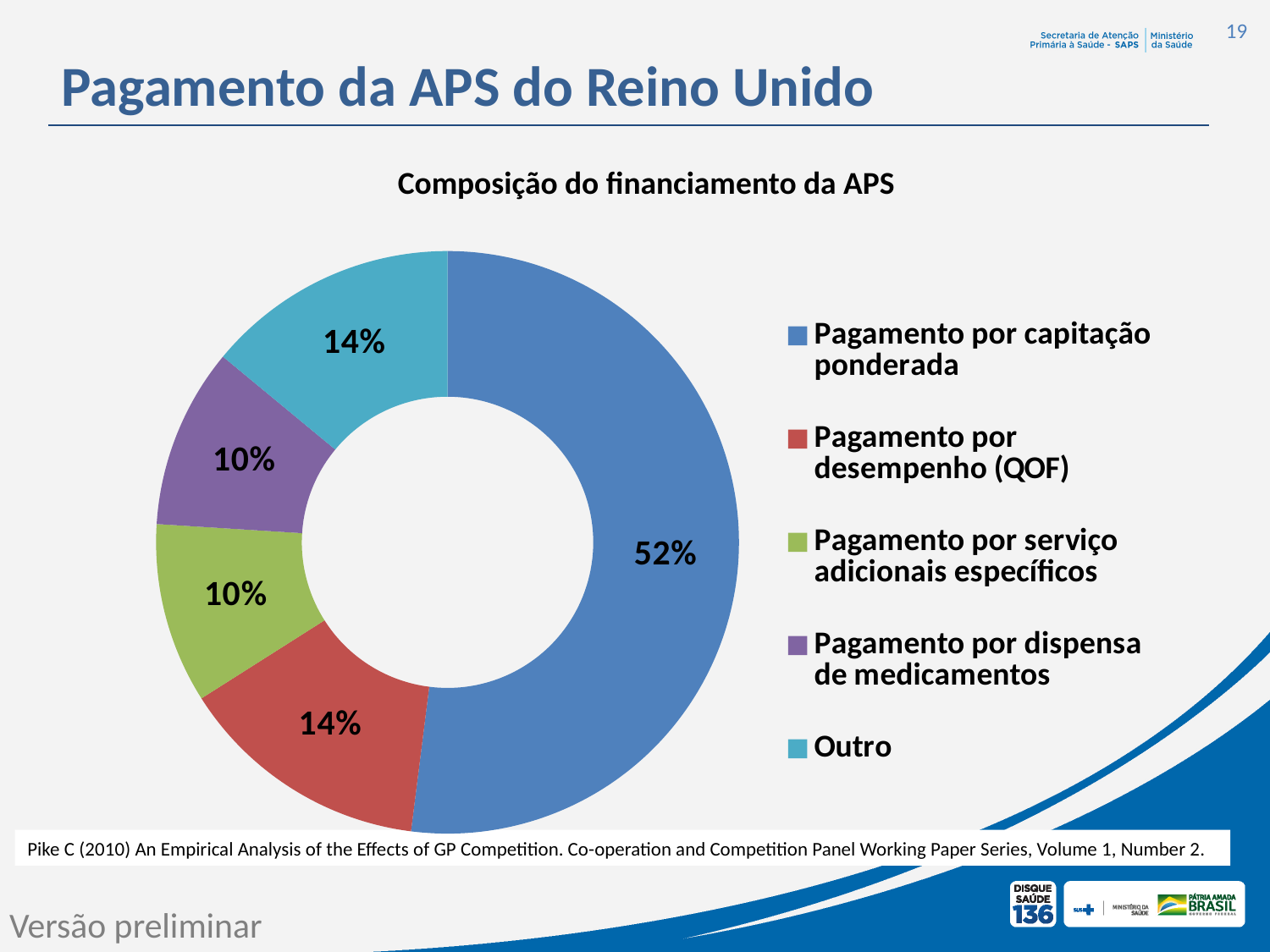
What kind of chart is shown on the slide? Pie chart (donut) What is the difference between the share for Pagamento por desempenho (QOF) and the share for Pagamento por dispensa de medicamentos? 4% What share of the chart does Pagamento por capitação ponderada represent? 52% How many categories are shown in the chart? 5 What is the value shown for Pagamento por dispensa de medicamentos? 10% What is the value shown for Outro? 14% What is the value shown for Pagamento por serviço adicionais específicos? 10% Which category has the largest share of the chart? Pagamento por capitação ponderada What is the title of the chart? Composição do financiamento da APS Which is larger: the share for Pagamento por desempenho (QOF) or the share for Pagamento por serviço adicionais específicos? Pagamento por desempenho (QOF) What is the difference between the share for Pagamento por capitação ponderada and the share for Outro? 38% What is the value shown for Pagamento por desempenho (QOF)? 14%